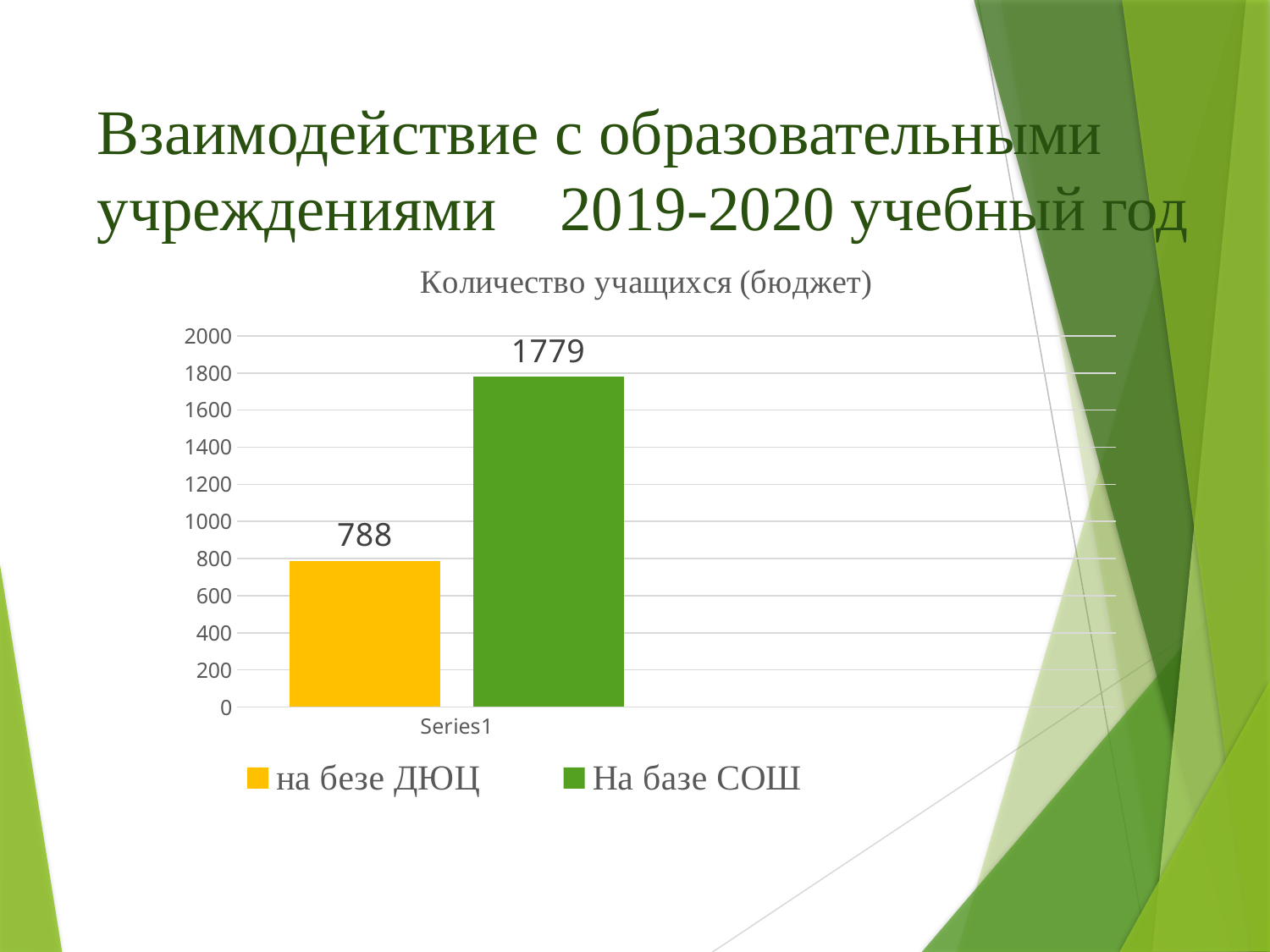
What is the title of the chart? Количество учащихся (бюджет) Is the value for "на безе ДЮЦ" greater or less than 1000? less How many series does the legend list? 2 What is the value for "на безе ДЮЦ"? 788 Which series has the highest value? На базе СОШ What colour is the bar for "На базе СОШ"? green Which is larger: the value for "на безе ДЮЦ" or the value for "На базе СОШ"? На базе СОШ What is the difference between the values for "На базе СОШ" and "на безе ДЮЦ"? 991 Which series has the lowest value? на безе ДЮЦ What is the value for "На базе СОШ"? 1779 Is the value for "На базе СОШ" greater or less than 1600? greater What kind of chart is shown on the slide? bar chart